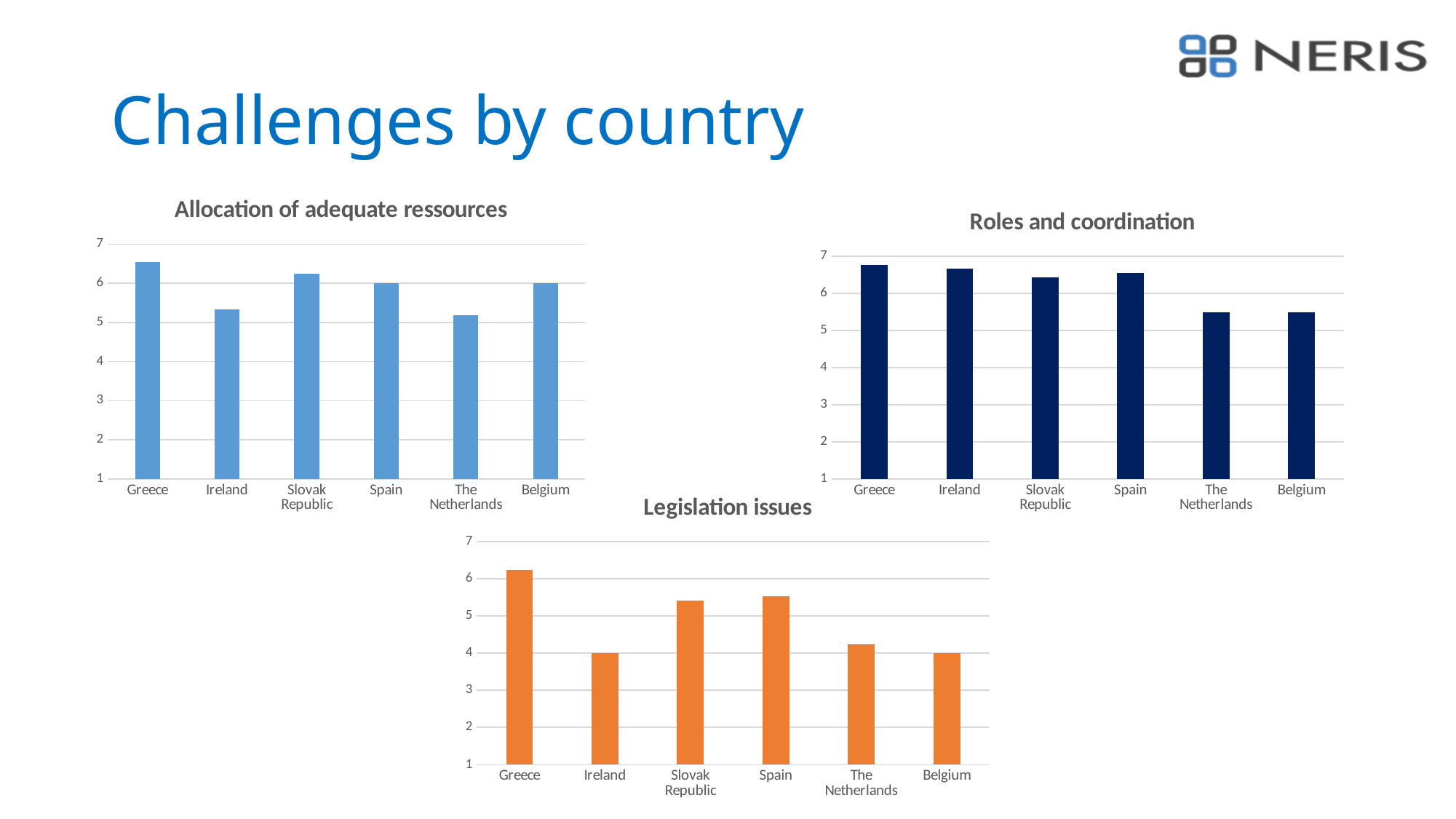
What colour are the bars in the "Legislation issues" chart? orange What is the title of the chart in the top right of the slide? Roles and coordination How many countries are shown in the "Allocation of adequate ressources" chart? 6 In the "Allocation of adequate ressources" chart, which country has the highest value? Greece In the "Legislation issues" chart, which country has the highest value? Greece In the "Roles and coordination" chart, is the value for The Netherlands greater or less than 6? less In the "Roles and coordination" chart, which is larger, the value for Greece or the value for Belgium? Greece In the "Legislation issues" chart, which is larger, the value for Spain or the value for The Netherlands? Spain In the "Legislation issues" chart, what is the value for Ireland? 4 In the "Allocation of adequate ressources" chart, is the value for Ireland greater or less than 5? greater In the "Legislation issues" chart, is the value for Greece greater or less than 6? greater What type of chart is the "Legislation issues" chart? bar chart